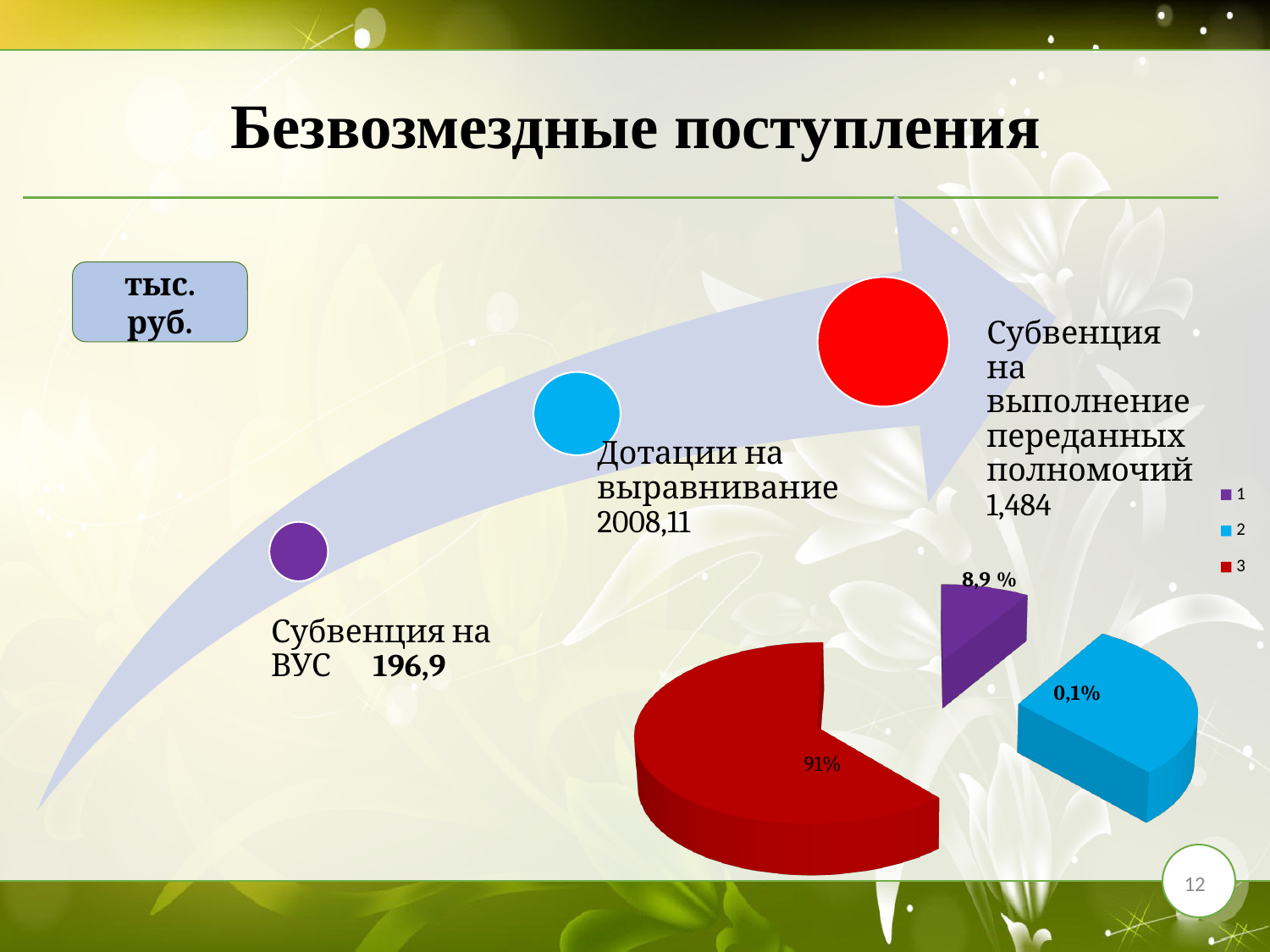
What colour is the largest slice of the pie chart? red Which legend entry corresponds to the largest slice of the pie chart? 3 How many entries does the pie chart's legend list? 3 In the pie chart, what share is shown for the purple slice (legend entry 1)? 8,9 % How many slices does the pie chart have? 3 In the pie chart, by how many percentage points does the red slice (3) exceed the purple slice (1)? 82,1 In the pie chart, what share is shown for the blue slice (legend entry 2)? 0,1% Which legend entry corresponds to the smallest slice of the pie chart? 1 In the pie chart, which slice is larger: legend entry 1 or legend entry 2? 2 What kind of chart is shown in the lower right of the slide? pie chart What are the labels listed in the pie chart's legend? 1, 2, 3 In the pie chart, what share is shown for the red slice (legend entry 3)? 91%